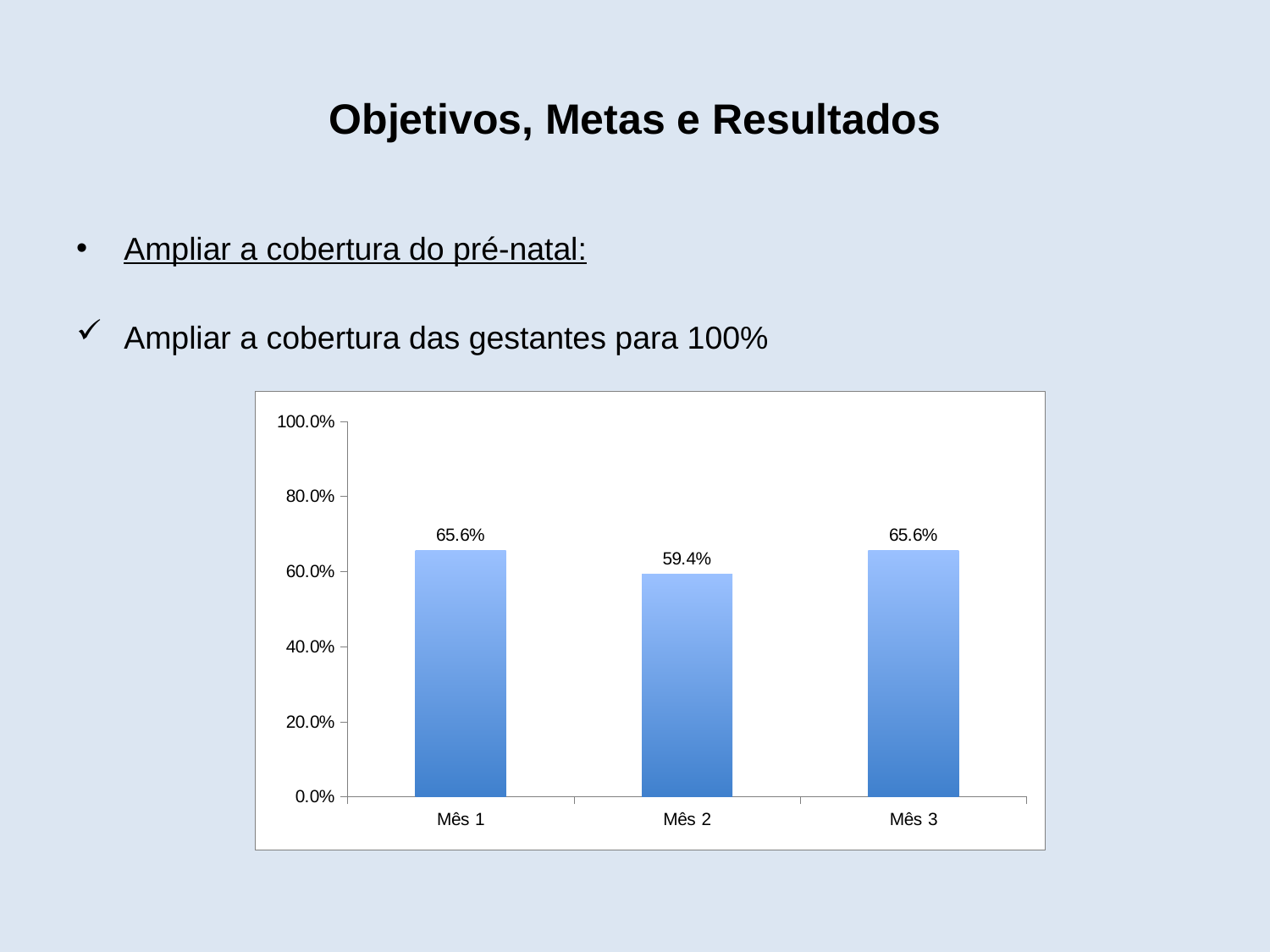
What is the value for Mês 1? 65.6% What is the difference between the values for Mês 1 and Mês 2? 6.2% Is the value for Mês 1 greater or less than 60.0%? greater What kind of chart is shown on the slide? bar chart Is the value for Mês 2 greater or less than 60.0%? less Which is larger, the value for Mês 2 or the value for Mês 3? Mês 3 How many categories are shown on the x axis? 3 What is the value for Mês 3? 65.6% Does the value fall or rise from Mês 2 to Mês 3? rise What is the value for Mês 2? 59.4% What is the highest value shown on the y axis? 100.0% Which category has the lowest value? Mês 2